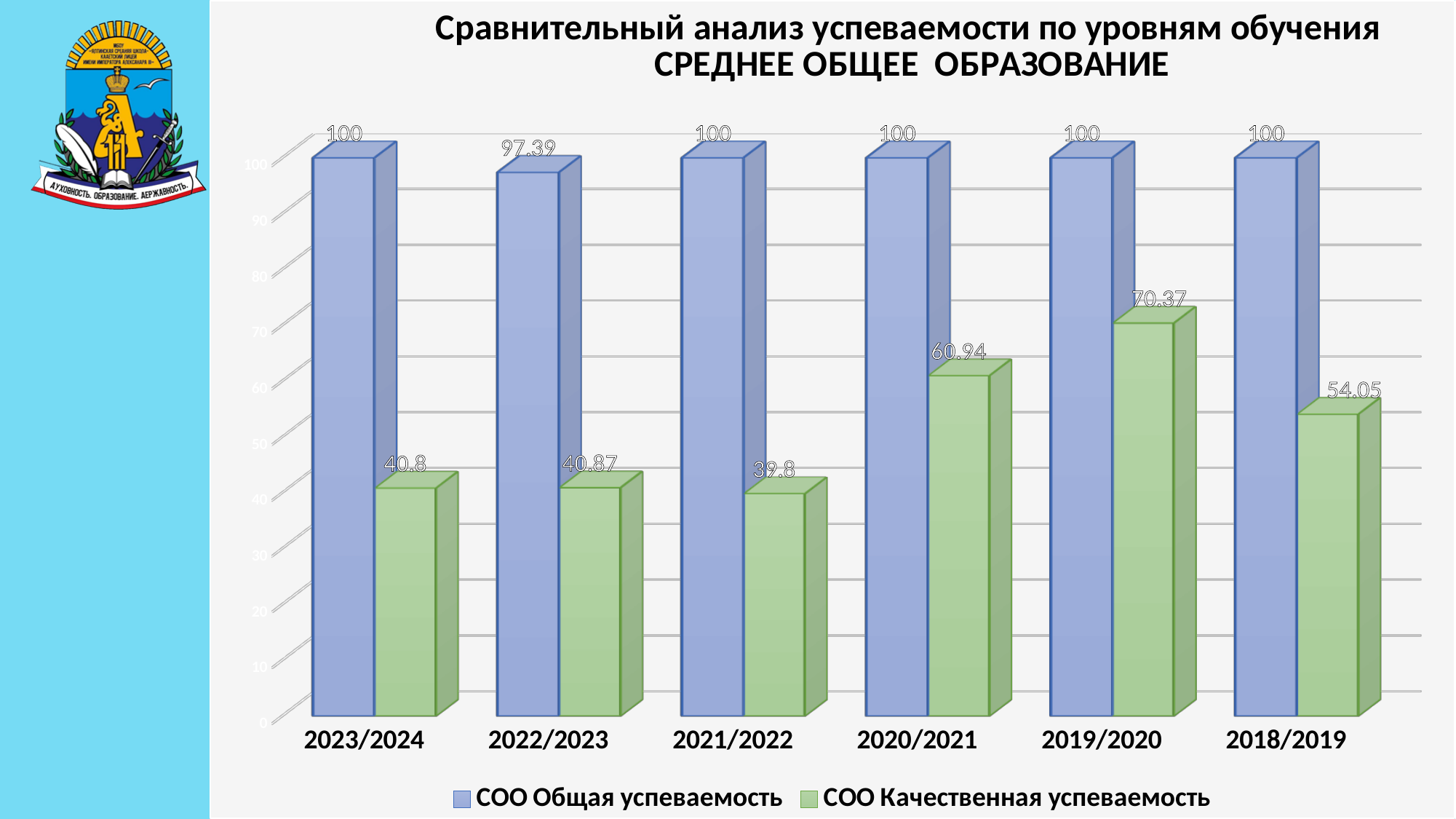
How many academic years are shown on the x axis? 6 Which series is shown in green in the legend? СОО Качественная успеваемость What type of chart is shown on the slide? bar chart Which academic year has the highest value of СОО Качественная успеваемость? 2019/2020 What is the value of СОО Общая успеваемость for 2022/2023? 97.39 Does СОО Качественная успеваемость rise or fall from 2020/2021 to 2019/2020 along the x axis? rise What is the difference between СОО Общая успеваемость and СОО Качественная успеваемость for 2018/2019? 45.95 Which academic year has the lowest value of СОО Общая успеваемость? 2022/2023 What is the value of СОО Качественная успеваемость for 2019/2020? 70.37 How many series does the legend list? 2 What is the value of СОО Качественная успеваемость for 2023/2024? 40.8 Which is larger: СОО Качественная успеваемость for 2020/2021 or for 2021/2022? 2020/2021